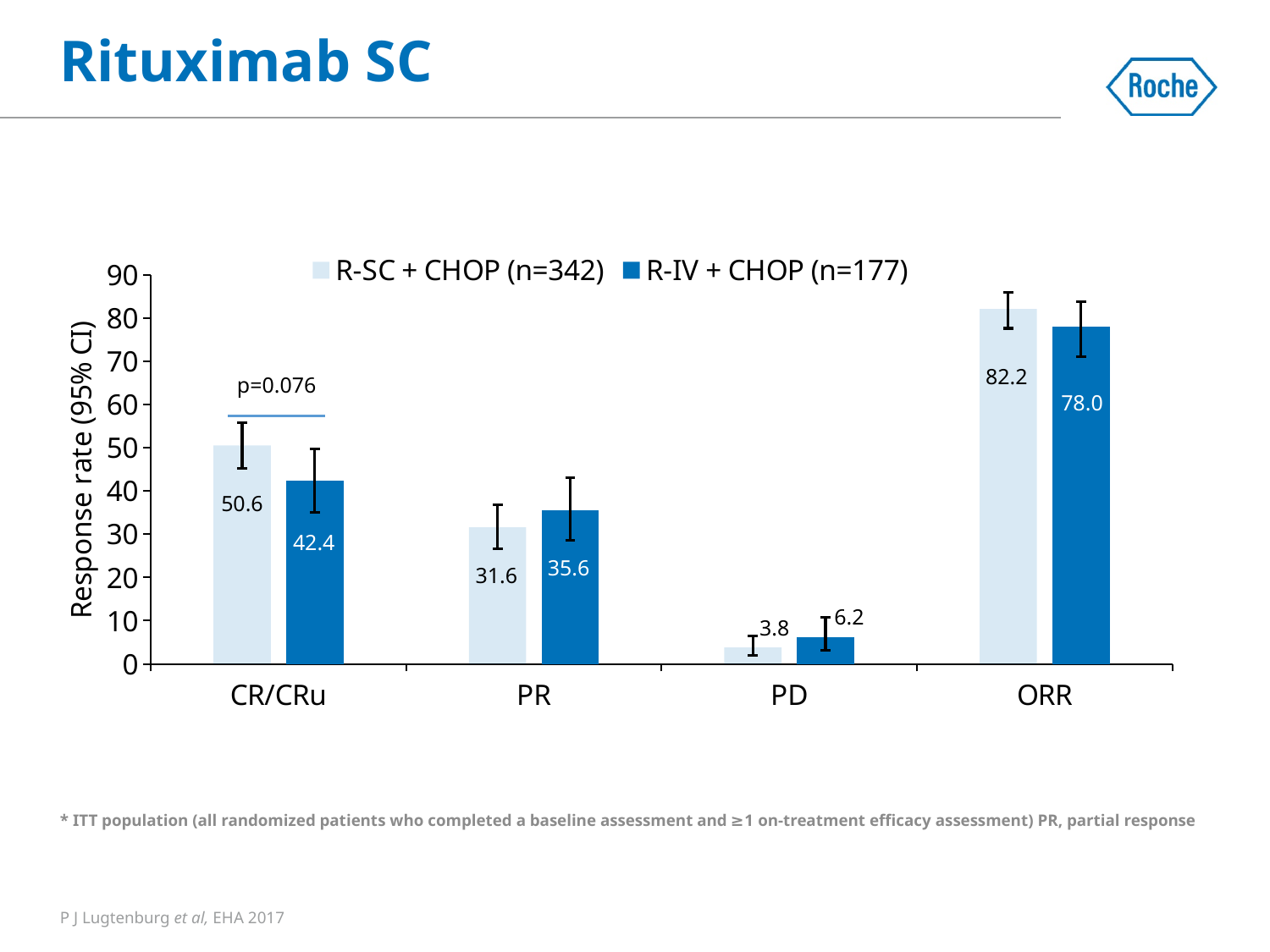
Which category has the lowest response rate for R-IV + CHOP (n=177)? PD What kind of chart is shown on the slide? bar chart How many categories are shown on the x axis? 4 How many series does the legend list? 2 What is the label of the y axis? Response rate (95% CI) What is the response rate for R-IV + CHOP (n=177) in the PR category? 35.6 What is the response rate for R-SC + CHOP (n=342) in the CR/CRu category? 50.6 What is the ORR value for R-IV + CHOP (n=177)? 78.0 Which category has the highest response rate for R-SC + CHOP (n=342)? ORR What is the difference between the R-SC + CHOP and R-IV + CHOP values in the CR/CRu category? 8.2 Which series has the larger value in the PD category, R-SC + CHOP (n=342) or R-IV + CHOP (n=177)? R-IV + CHOP (n=177) Is the ORR value for R-SC + CHOP (n=342) greater or less than 80? greater